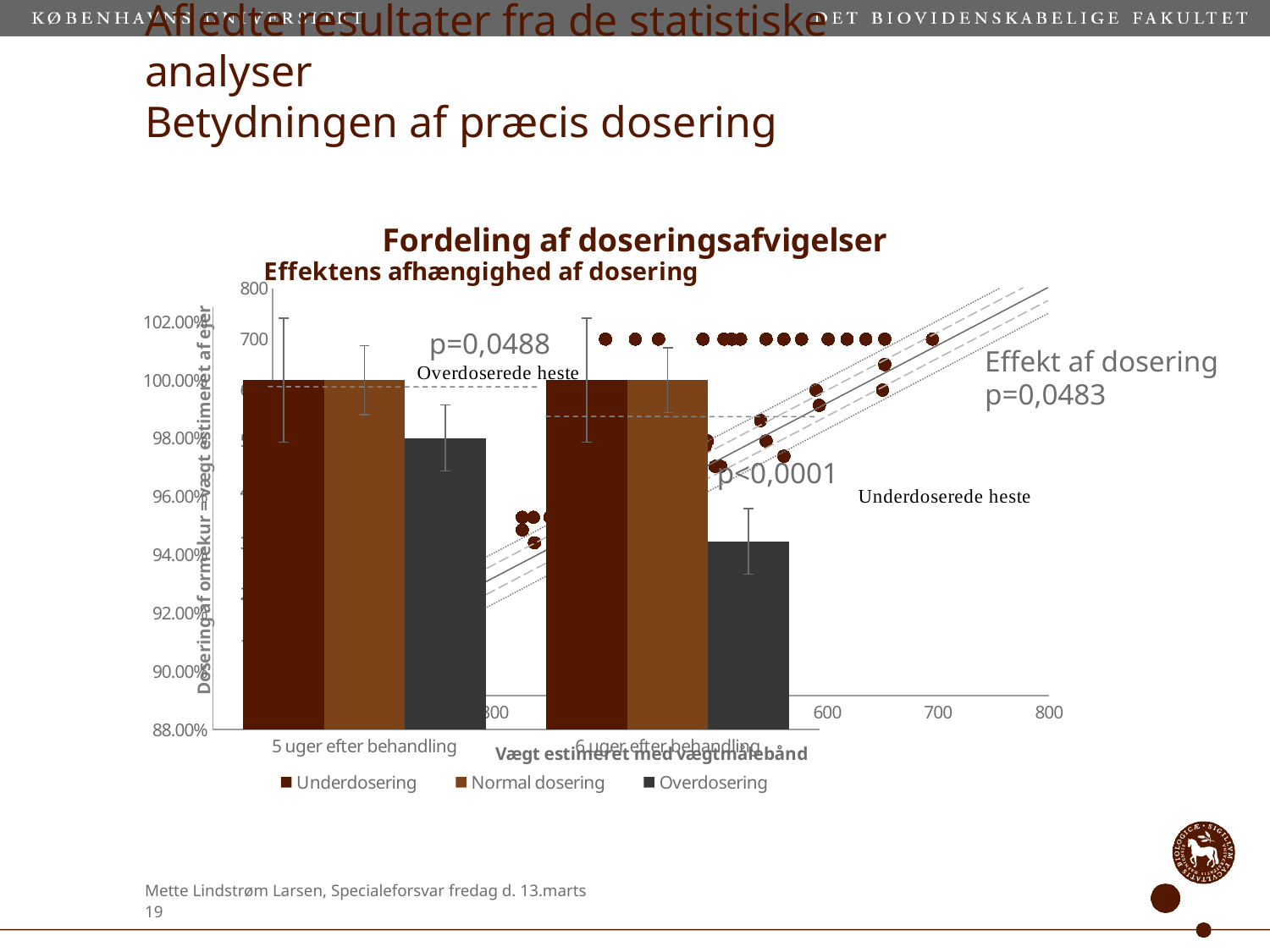
What kind of chart is "Effektens afhængighed af dosering"? bar chart In the "Effektens afhængighed af dosering" chart, is the Overdosering value for "6 uger efter behandling" greater or less than 96.00%? less What kind of chart is "Fordeling af doseringsafvigelser"? scatter chart What are the legend entries of the "Effektens afhængighed af dosering" chart? Underdosering, Normal dosering, Overdosering In the "Effektens afhængighed af dosering" chart, is the Overdosering value for "5 uger efter behandling" greater or less than 96.00%? greater In the "Effektens afhængighed af dosering" chart, does the Overdosering value rise or fall from "5 uger efter behandling" to "6 uger efter behandling"? fall How many categories are shown on the x axis of the "Effektens afhængighed af dosering" chart? 2 What is the x-axis title of the "Fordeling af doseringsafvigelser" chart? Vægt estimeret med vægtmålebånd In the "Effektens afhængighed af dosering" chart, which series has the lowest value for "6 uger efter behandling"? Overdosering In the "Effektens afhængighed af dosering" chart, is the Overdosering value larger for "5 uger efter behandling" or "6 uger efter behandling"? 5 uger efter behandling In the "Effektens afhængighed af dosering" chart, what is the Underdosering value for "6 uger efter behandling"? 100.00% How many series does the legend of the "Effektens afhængighed af dosering" chart list? 3